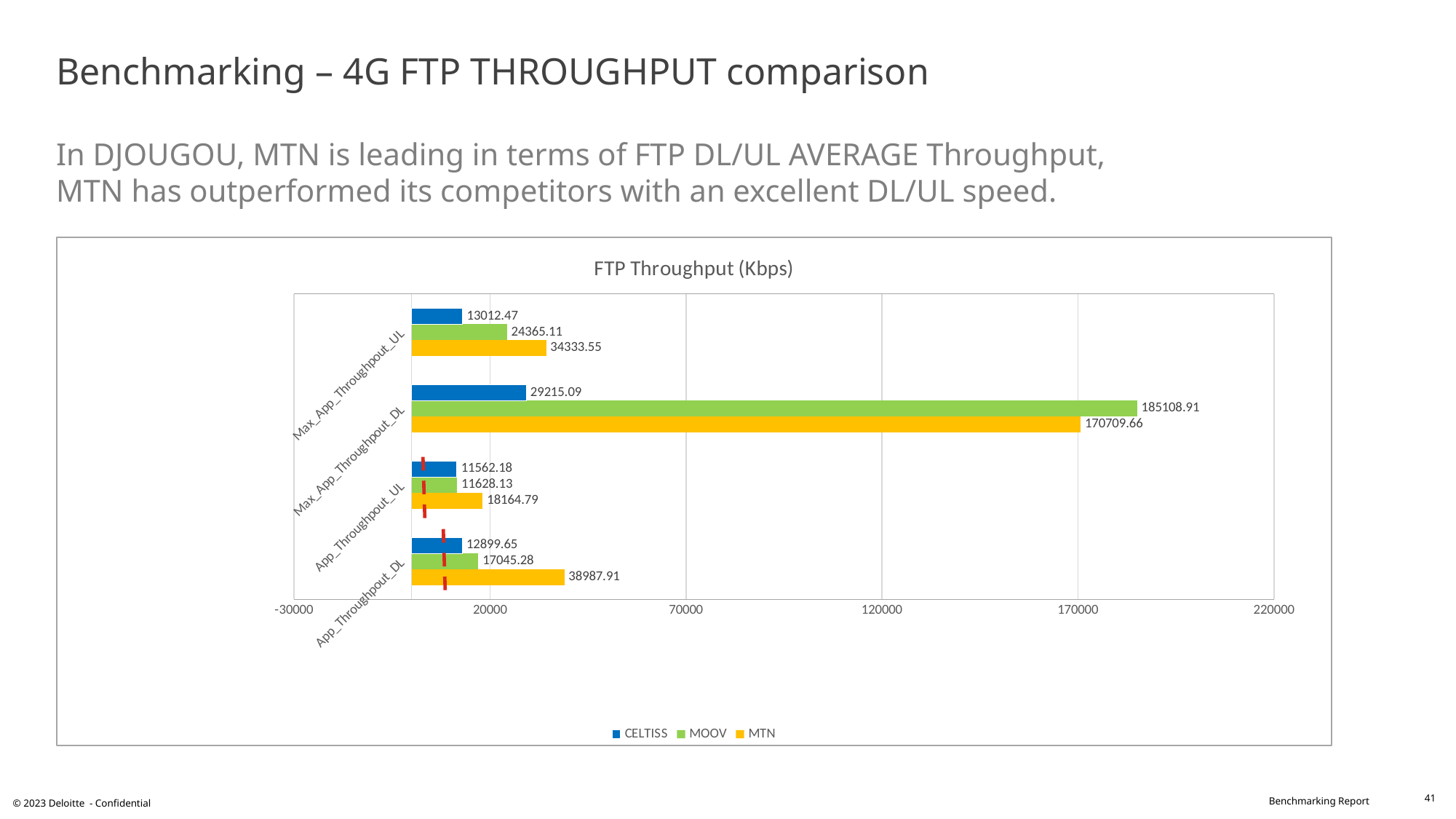
What is the difference between the MOOV and MTN values for Max_App_Throughput_DL? 14399.25 Which operator has the lowest value for Max_App_Throughput_DL? CELTISS Which is larger for App_Throughput_DL: the MOOV value or the MTN value? MTN What is the title of the chart? FTP Throughput (Kbps) Is the MTN value for Max_App_Throughput_DL greater or less than 120000? greater How many series does the legend list? 3 What is the MOOV value for Max_App_Throughput_DL? 185108.91 How many categories are shown on the chart? 4 What is the CELTISS value for App_Throughput_UL? 11562.18 What is the MTN value for App_Throughput_DL? 38987.91 Which operator has the highest value for Max_App_Throughput_UL? MTN What type of chart is shown on the slide? Bar chart